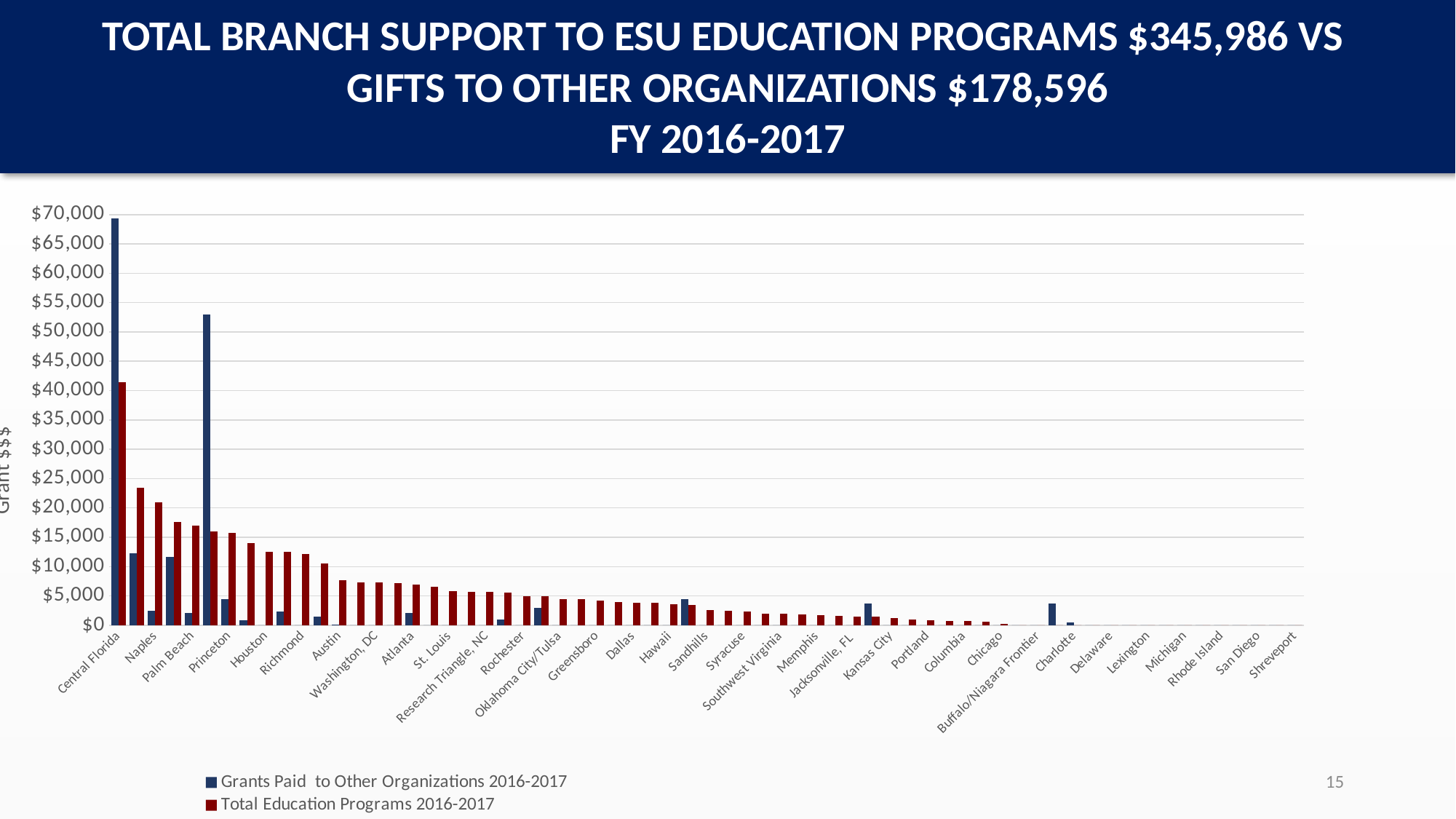
Is the Grants Paid to Other Organizations 2016-2017 value for Princeton greater or less than $50,000? less Which branch has the highest value for Grants Paid to Other Organizations 2016-2017? Central Florida Which branch has the highest value for Total Education Programs 2016-2017? Central Florida How many series does the legend list? 2 Is the Total Education Programs 2016-2017 value for Central Florida greater or less than $35,000? greater What is the title of the vertical axis? Grant $$$ What kind of chart is shown on the slide? bar chart Do the Total Education Programs 2016-2017 values generally rise or fall from left to right along the x axis? fall Which is larger: the Grants Paid to Other Organizations 2016-2017 value for Central Florida or for Princeton? Central Florida For Central Florida, which series has the larger value: Grants Paid to Other Organizations 2016-2017 or Total Education Programs 2016-2017? Grants Paid to Other Organizations 2016-2017 Is the Total Education Programs 2016-2017 value for Princeton greater or less than $20,000? less